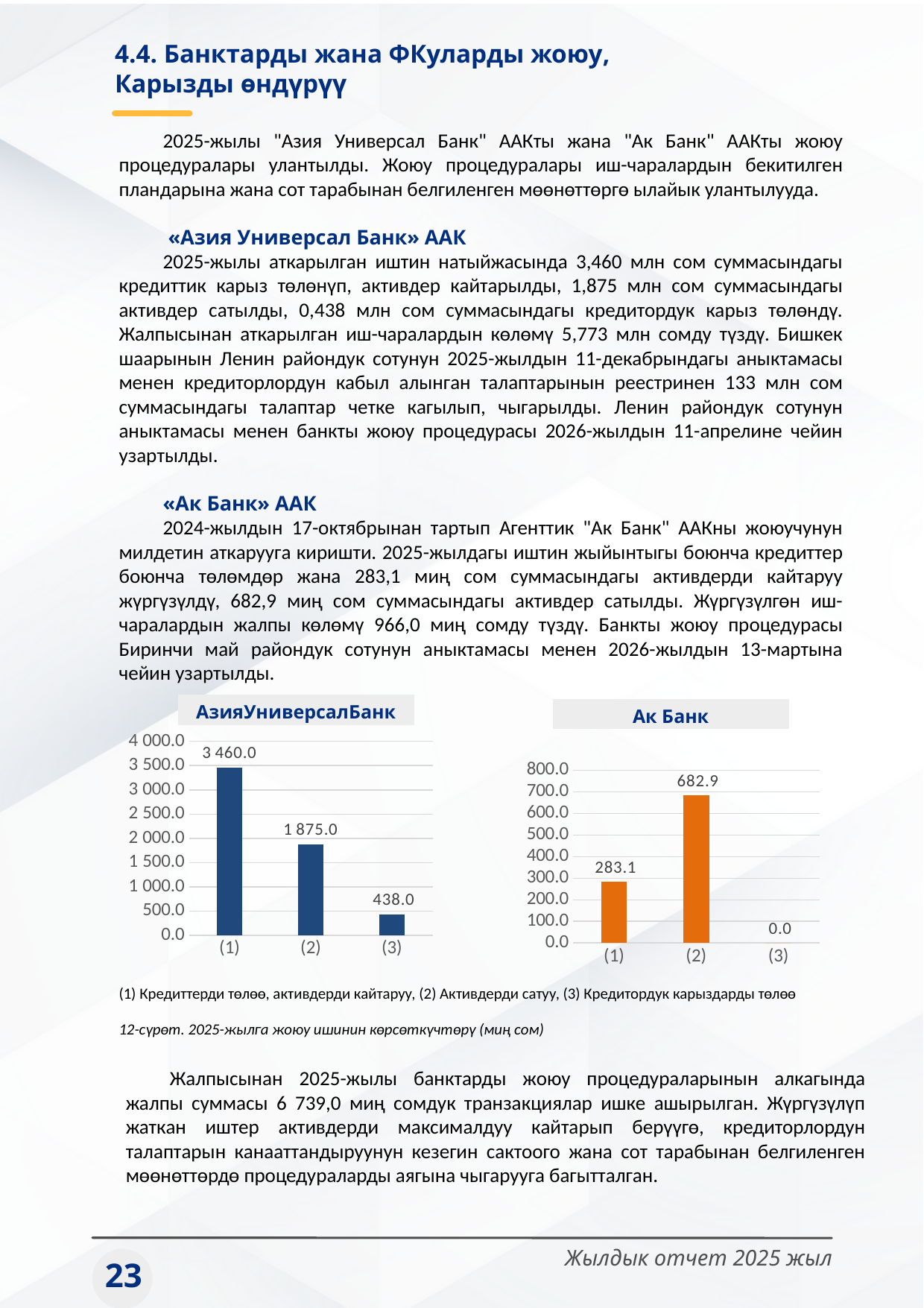
In the АзияУниверсалБанк chart, what is the value for category (3)? 438.0 What type of chart is the Ак Банк chart? Bar chart In the АзияУниверсалБанк chart, which category has the highest value? (1) In the Ак Банк chart, what is the difference between the values for categories (2) and (1)? 399.8 In the АзияУниверсалБанк chart, what is the difference between the values for categories (1) and (2)? 1 585.0 How many categories are shown in the АзияУниверсалБанк chart? 3 In the АзияУниверсалБанк chart, do the values rise or fall from category (1) to category (3)? Fall In the Ак Банк chart, what is the value for category (3)? 0.0 In the Ак Банк chart, what is the value for category (2)? 682.9 In the Ак Банк chart, which is larger, the value for category (1) or category (2)? (2) In the АзияУниверсалБанк chart, what is the value for category (1)? 3 460.0 In the Ак Банк chart, which category has the lowest value? (3)